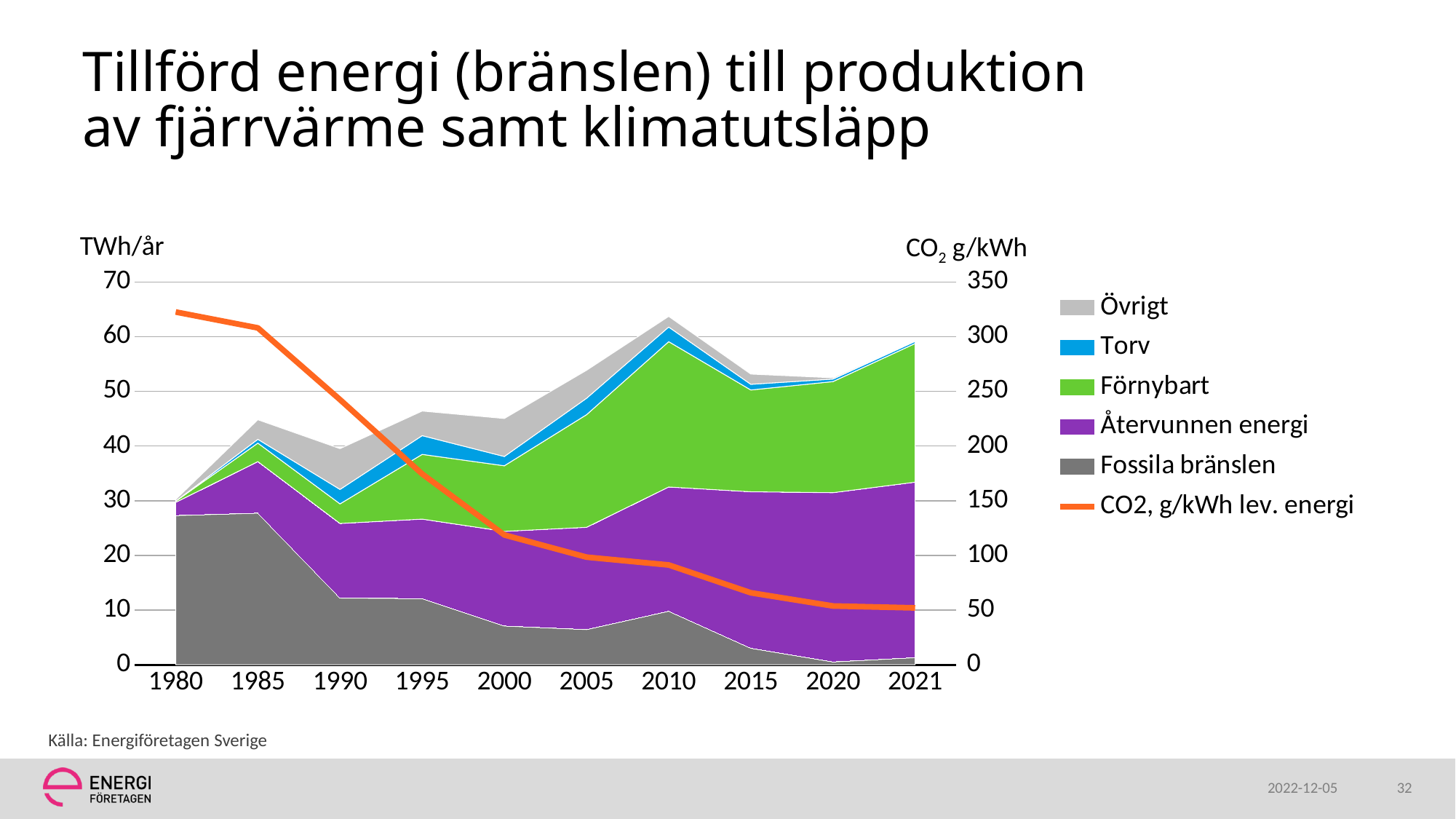
How many series does the legend list? 6 Is the CO2, g/kWh lev. energi value in 1980 greater or less than 300? greater How many years are labelled on the x axis? 10 What kind of chart is shown on the slide? Stacked area chart with a line Is the Fossila bränslen value in 2021 greater or less than 10 TWh/år? less Does the CO2, g/kWh lev. energi line rise or fall from 1980 to 2021? Fall What unit is shown on the left vertical axis? TWh/år In which year is the CO2, g/kWh lev. energi value highest? 1980 Is the Fossila bränslen value in 1980 greater or less than 20 TWh/år? greater Which series is shown in green in the legend? Förnybart Is the CO2, g/kWh lev. energi value larger in 1980 or in 2021? 1980